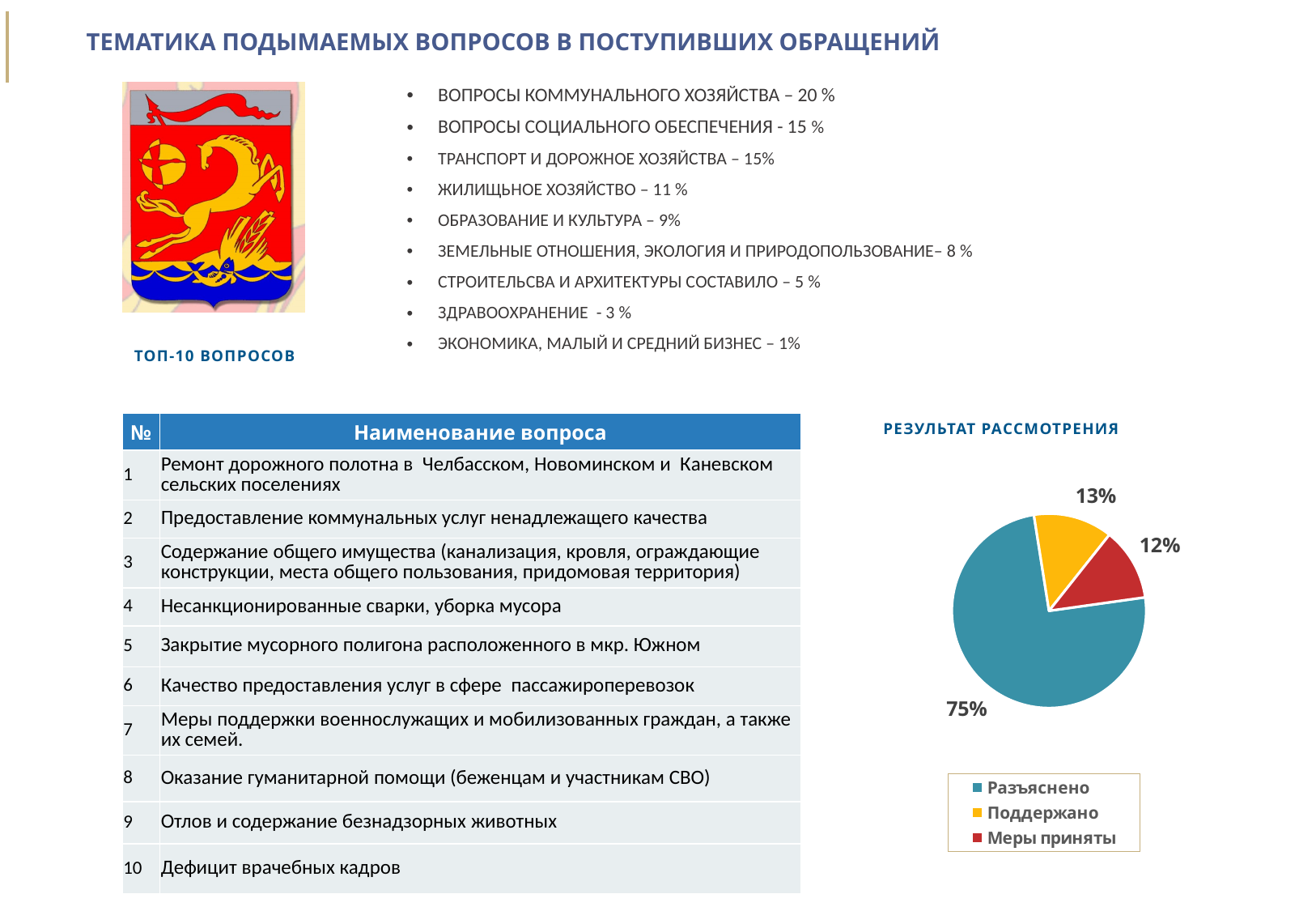
In the pie chart "РЕЗУЛЬТАТ РАССМОТРЕНИЯ", what share is shown for "Разъяснено"? 75% In the pie chart "РЕЗУЛЬТАТ РАССМОТРЕНИЯ", what colour is the slice for "Меры приняты"? Red In the pie chart "РЕЗУЛЬТАТ РАССМОТРЕНИЯ", what is the difference in percentage points between "Разъяснено" and "Поддержано"? 62 percentage points What kind of chart is shown under the heading "РЕЗУЛЬТАТ РАССМОТРЕНИЯ"? Pie chart In the pie chart "РЕЗУЛЬТАТ РАССМОТРЕНИЯ", what share is shown for "Поддержано"? 13% How many entries does the legend of the pie chart "РЕЗУЛЬТАТ РАССМОТРЕНИЯ" list? 3 In the pie chart "РЕЗУЛЬТАТ РАССМОТРЕНИЯ", what colour is the slice for "Разъяснено"? Teal In the pie chart "РЕЗУЛЬТАТ РАССМОТРЕНИЯ", which category has the largest slice? Разъяснено In the pie chart "РЕЗУЛЬТАТ РАССМОТРЕНИЯ", which is larger: "Поддержано" or "Меры приняты"? Поддержано In the pie chart "РЕЗУЛЬТАТ РАССМОТРЕНИЯ", how many slices does the pie have? 3 In the pie chart "РЕЗУЛЬТАТ РАССМОТРЕНИЯ", which category has the smallest slice? Меры приняты In the pie chart "РЕЗУЛЬТАТ РАССМОТРЕНИЯ", what share is shown for "Меры приняты"? 12%